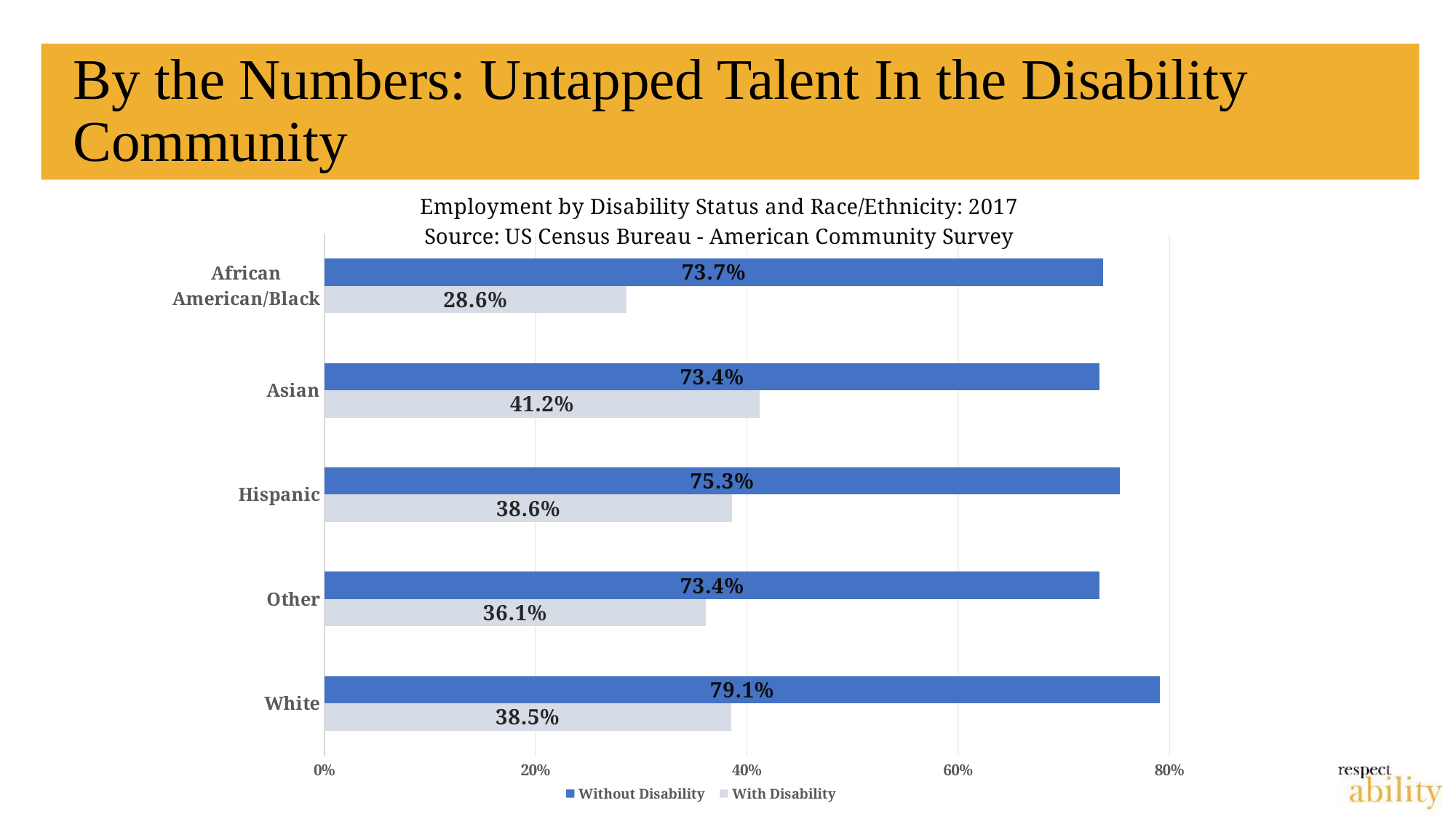
How many series does the legend list? 2 What is the employment rate for Asian people with a disability? 41.2% What is the difference between the employment rates of Hispanic people without a disability and with a disability? 36.7% What is the title of the chart? Employment by Disability Status and Race/Ethnicity: 2017 How many race/ethnicity categories are shown in the chart? 5 Is the employment rate for Other people with a disability greater or less than 40%? less What is the employment rate for White people without a disability? 79.1% What is the employment rate for African American/Black people with a disability? 28.6% What kind of chart is shown on the slide? Bar chart Which race/ethnicity has the lowest employment rate for people with a disability? African American/Black Which race/ethnicity has the highest employment rate for people without a disability? White Which is larger: the employment rate for Asian people with a disability or for Other people with a disability? Asian